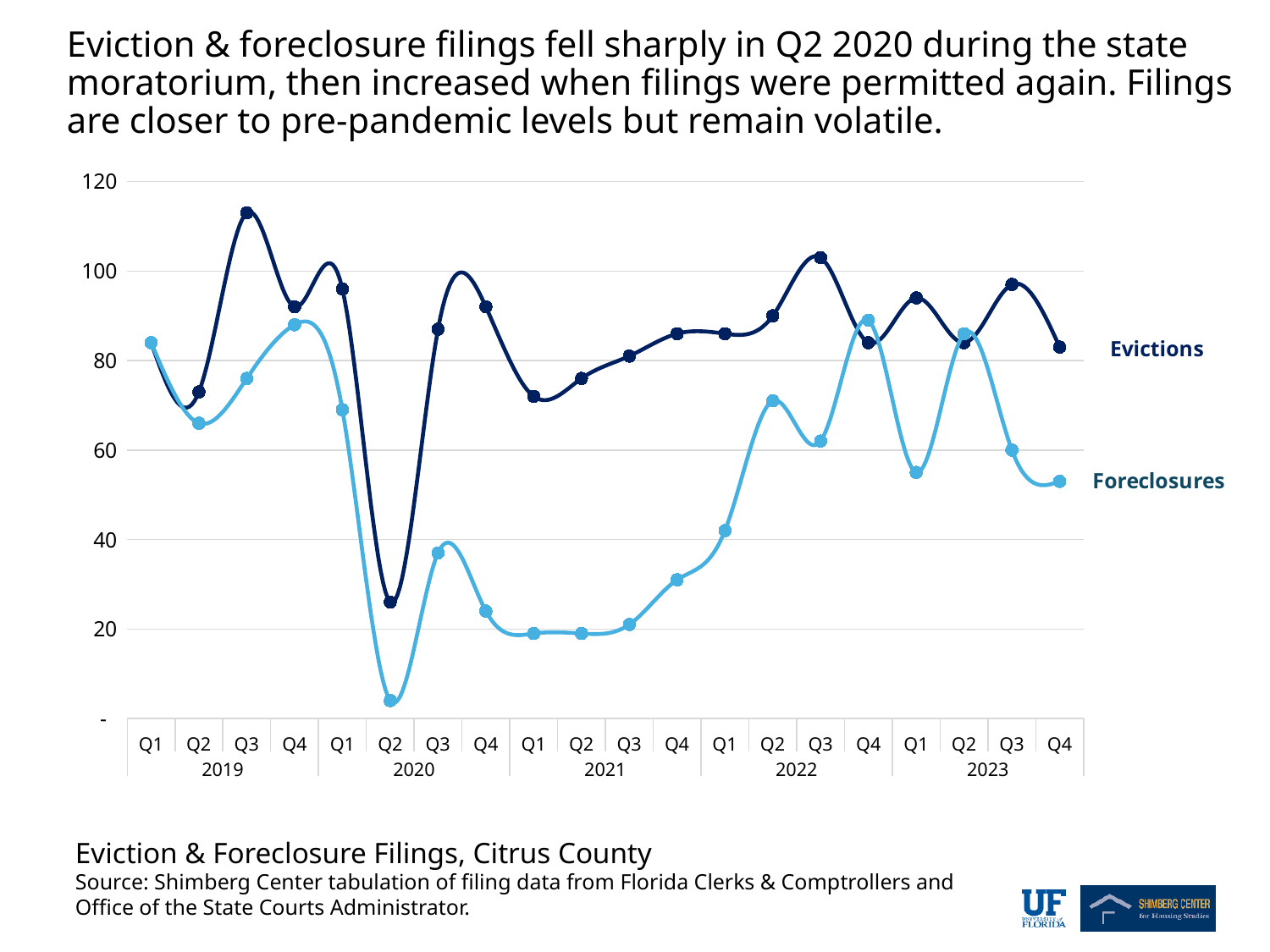
Do Foreclosures rise or fall from Q1 2021 to Q2 2022? rise In which quarter do Foreclosures reach their lowest value? Q2 2020 How many series does the chart show? 2 How many quarterly data points does each line have? 20 In which quarter do Evictions reach their highest value? Q3 2019 What kind of chart is shown on the slide? line chart In which quarter do Evictions reach their lowest value? Q2 2020 Is the value for Evictions in Q3 2019 greater or less than 100? greater What are the two series plotted on the chart? Evictions and Foreclosures Is the value for Foreclosures in Q2 2022 greater or less than 60? greater In Q2 2020, which series has the larger value, Evictions or Foreclosures? Evictions Is the value for Foreclosures in Q2 2020 greater or less than 20? less